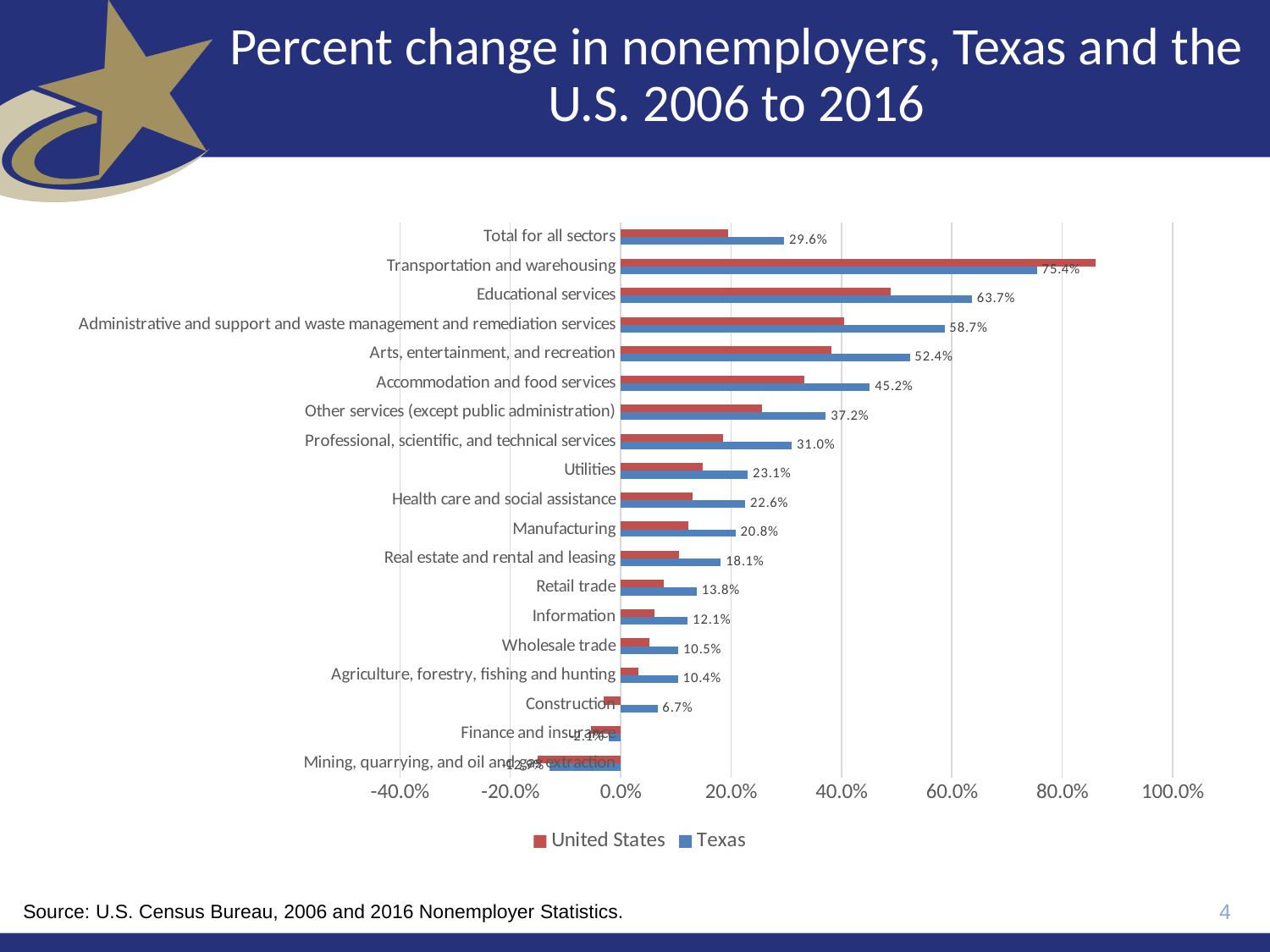
How many series does the legend list? 2 What is the Texas value for Total for all sectors? 29.6% Which has the larger Texas value, Utilities or Health care and social assistance? Utilities What is the difference between the Texas values for Educational services and Administrative and support and waste management and remediation services? 5.0 percentage points For Transportation and warehousing, which series has the larger value, United States or Texas? United States Which sector has the highest Texas value? Transportation and warehousing What is the Texas value for Educational services? 63.7% How many sector categories are shown on the chart? 19 What kind of chart is shown on the slide? Bar chart What is the Texas value for Construction? 6.7% Is the United States value for Transportation and warehousing greater or less than 80.0%? greater What is the Texas value for Transportation and warehousing? 75.4%